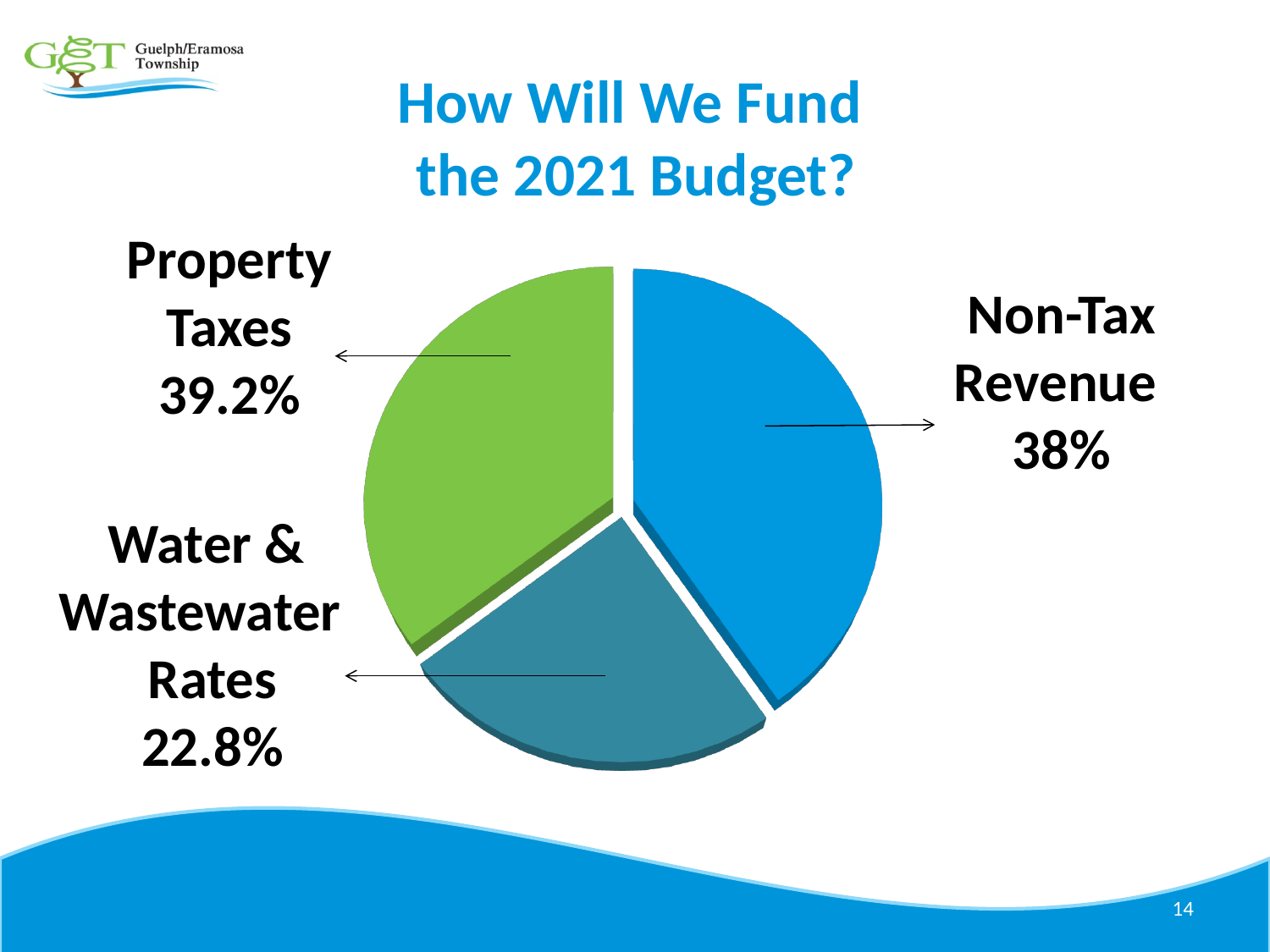
What kind of chart is shown on the slide? Pie chart What share of the 2021 budget funding comes from Water & Wastewater Rates? 22.8% What share of the 2021 budget funding comes from Non-Tax Revenue? 38% Which funding source has the smallest share of the pie? Water & Wastewater Rates How many slices does the pie chart have? 3 What share of the 2021 budget funding comes from Property Taxes? 39.2% Which is larger: the share for Non-Tax Revenue or the share for Water & Wastewater Rates? Non-Tax Revenue What is the difference in percentage points between Non-Tax Revenue and Water & Wastewater Rates? 15.2 What colour is the Property Taxes slice? Green What is the title of the slide containing the chart? How Will We Fund the 2021 Budget? What is the difference in percentage points between Property Taxes and Water & Wastewater Rates? 16.4